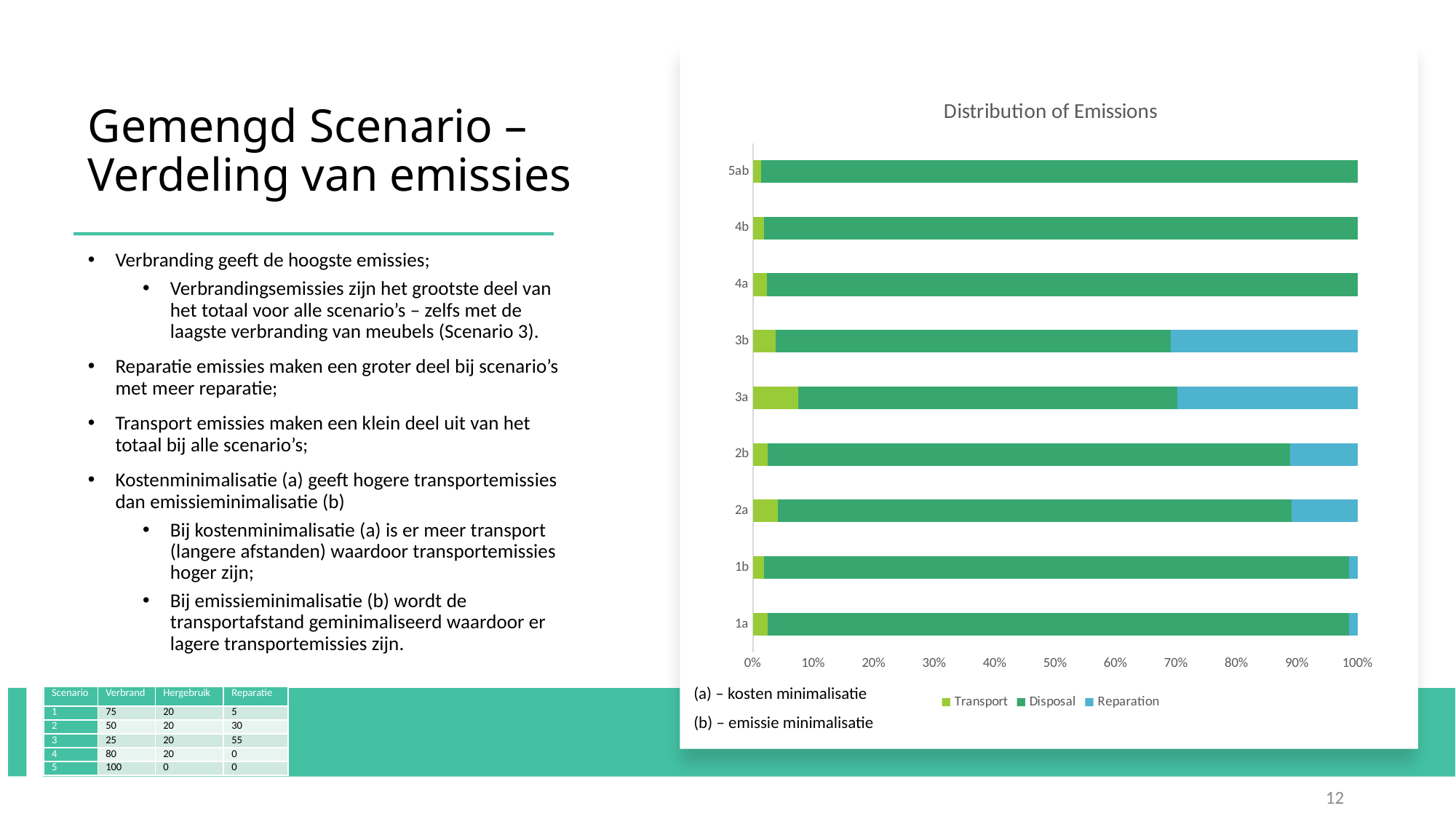
Is the Disposal share for 5ab greater or less than 90%? greater What type of chart is shown on the slide? Stacked bar chart How many scenario categories are plotted on the vertical axis of the chart? 9 Which category has the largest Transport share in the chart? 3a Which has the larger Transport share, 3a or 3b? 3a Which category has the smallest Transport share in the chart? 5ab Which series are listed in the chart legend? Transport, Disposal, Reparation How many series does the chart legend list? 3 What is the title of the chart? Distribution of Emissions Is the Reparation share for 3b greater or less than 20%? greater Which has the larger Reparation share, 2a or 3a? 3a Is the Transport share for 3a greater or less than 10%? less